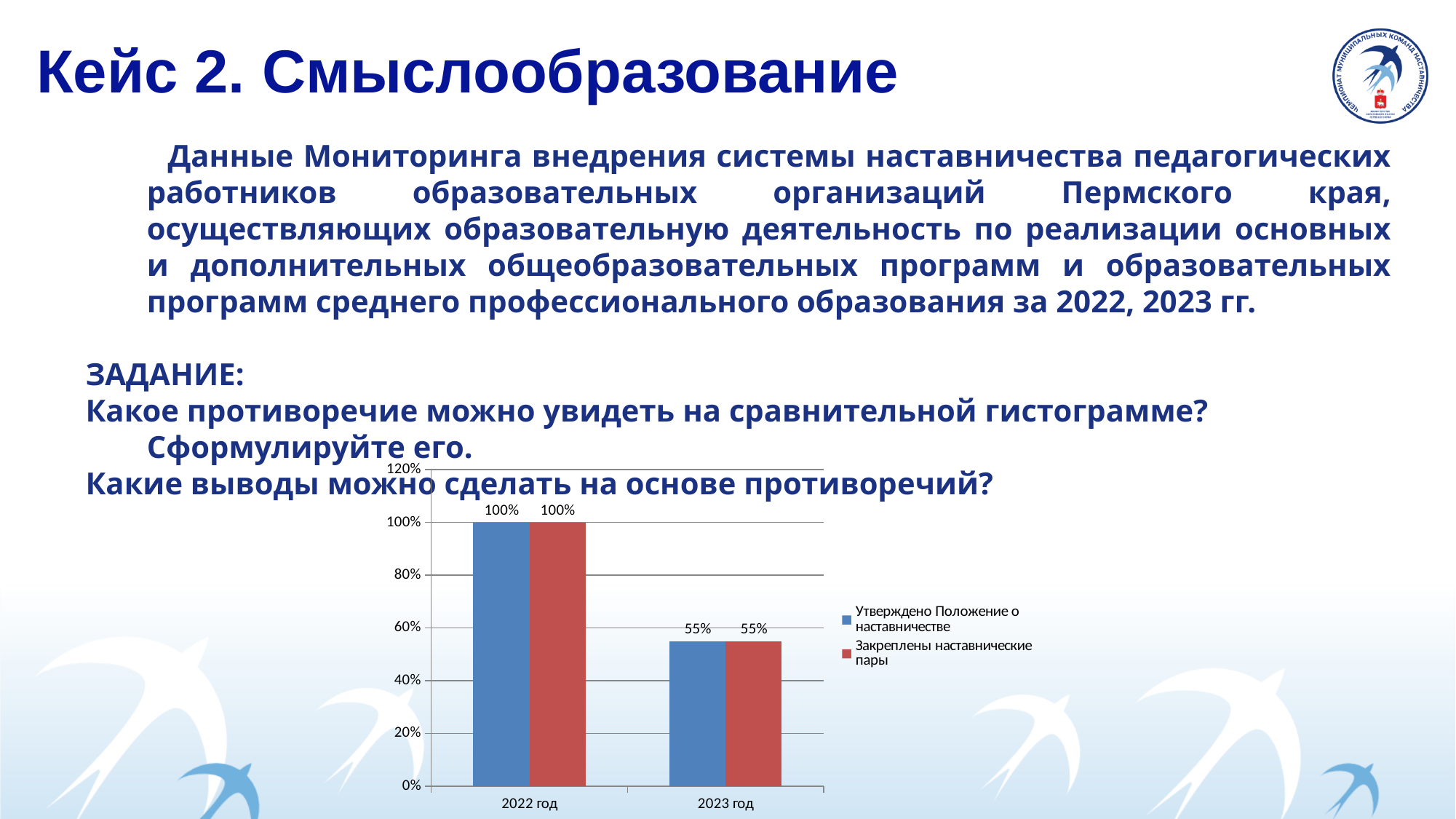
Which year has the lowest value for 'Утверждено Положение о наставничестве'? 2023 год What is the value for 'Утверждено Положение о наставничестве' in 2023 год? 55% What is the value for 'Закреплены наставнические пары' in 2023 год? 55% How many series does the chart legend list? 2 Is the value for 'Закреплены наставнические пары' in 2022 год larger or smaller than in 2023 год? larger What is the difference between the 2022 год and 2023 год values for 'Утверждено Положение о наставничестве'? 45% How many categories are shown on the x axis of the chart? 2 Is the value for 'Закреплены наставнические пары' in 2023 год greater or less than 60%? less Which year has the highest value for 'Закреплены наставнические пары'? 2022 год What kind of chart is shown on the slide? bar chart What is the value for 'Утверждено Положение о наставничестве' in 2022 год? 100% Do the values for 'Утверждено Положение о наставничестве' rise or fall from 2022 год to 2023 год? fall